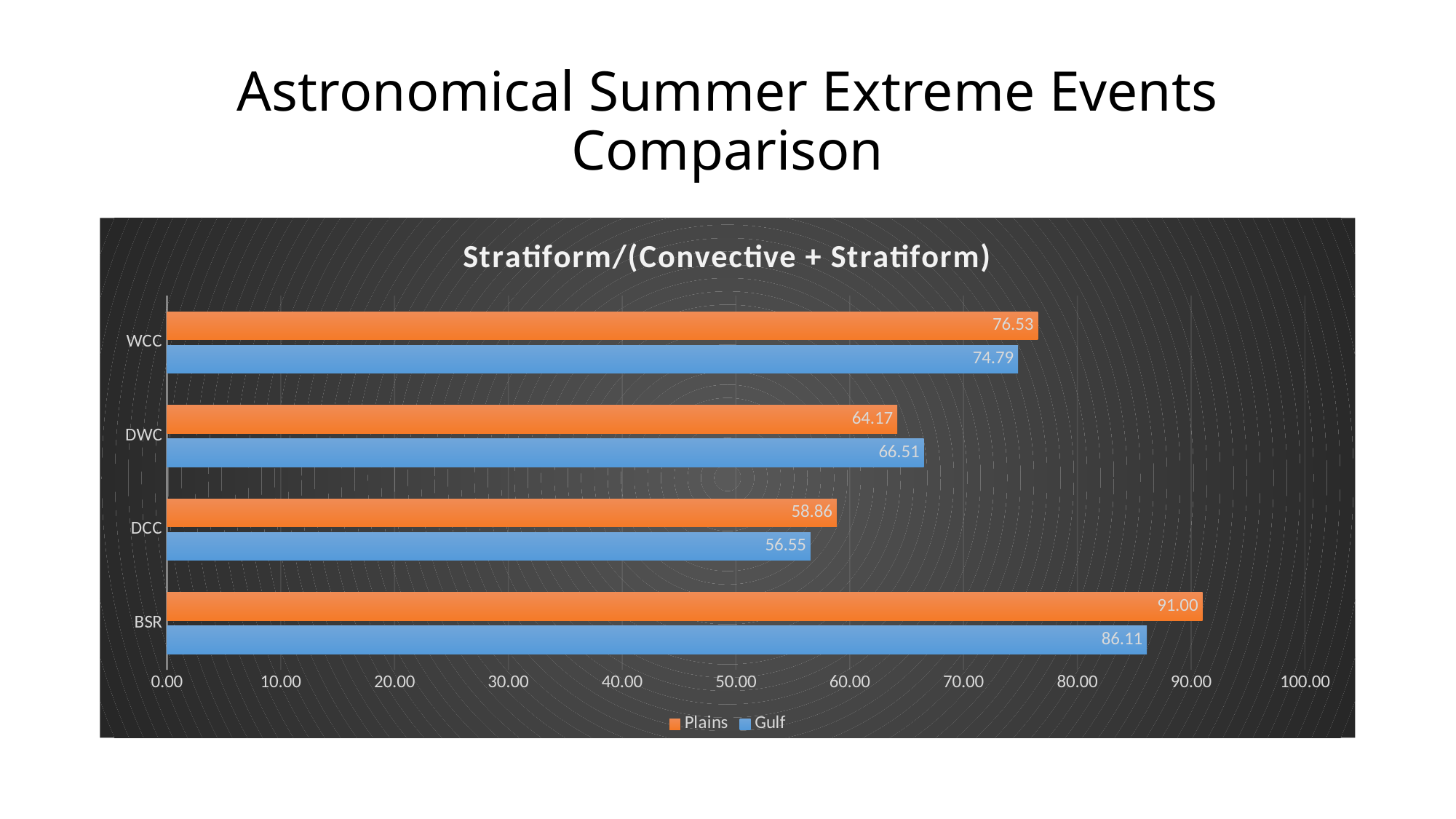
What is the Plains value for WCC? 76.53 What is the difference between the Gulf and Plains values for DWC? 2.34 What is the Gulf value for DWC? 66.51 For DCC, which series has the larger value, Plains or Gulf? Plains What is the Gulf value for BSR? 86.11 Which category has the highest Plains value? BSR How many series does the legend list? 2 What is the difference between the Plains and Gulf values for BSR? 4.89 Which category has the lowest Gulf value? DCC How many categories are shown on the chart? 4 Is the Gulf value for WCC greater or less than 70.00? greater What kind of chart is shown on the slide? Bar chart